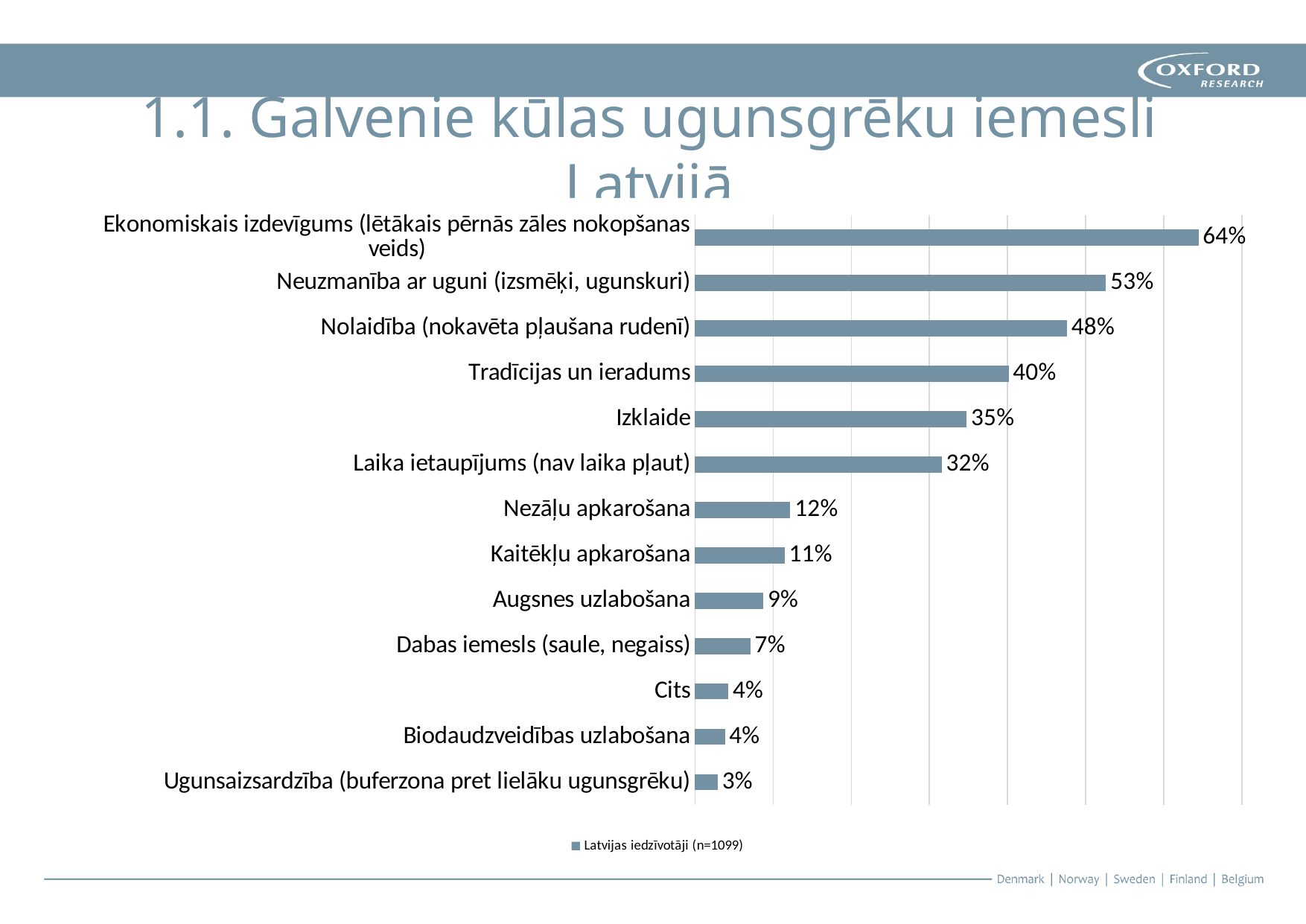
Which is larger, the value for Laika ietaupījums (nav laika pļaut) or the value for Kaitēkļu apkarošana? Laika ietaupījums (nav laika pļaut) What is the legend entry of the chart? Latvijas iedzīvotāji (n=1099) What is the value for Izklaide? 35% Which category has the lowest value? Ugunsaizsardzība (buferzona pret lielāku ugunsgrēku) What is the value for Nolaidība (nokavēta pļaušana rudenī)? 48% What kind of chart is shown on the slide? Bar chart What is the value for Dabas iemesls (saule, negaiss)? 7% What is the difference between the values for Nezāļu apkarošana and Augsnes uzlabošana? 3% What is the difference between the values for Neuzmanība ar uguni (izsmēķi, ugunskuri) and Tradīcijas un ieradums? 13% Which category has the highest value? Ekonomiskais izdevīgums (lētākais pērnās zāles nokopšanas veids) How many categories does the chart show? 13 How many series does the legend list? 1